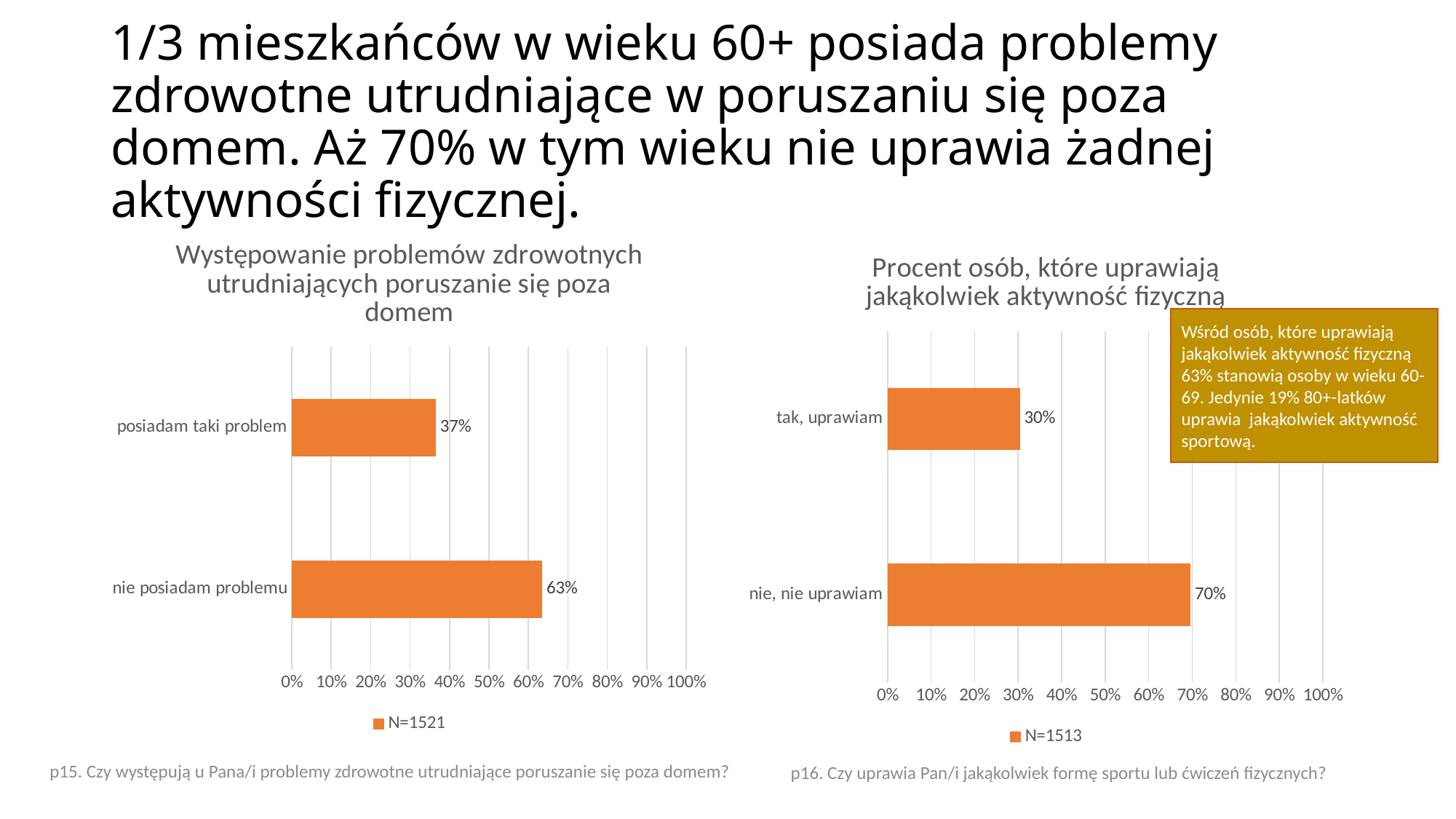
What type of chart is the right chart (Procent osób, które uprawiają jakąkolwiek aktywność fizyczną)? bar chart In the left chart, which category has the highest value? nie posiadam problemu In the left chart (Występowanie problemów zdrowotnych utrudniających poruszanie się poza domem), what is the value for 'nie posiadam problemu'? 63% In the left chart (Występowanie problemów zdrowotnych utrudniających poruszanie się poza domem), what is the value for 'posiadam taki problem'? 37% In the right chart, what is the difference between 'nie, nie uprawiam' and 'tak, uprawiam'? 40% What legend entry is shown under the left chart? N=1521 In the right chart (Procent osób, które uprawiają jakąkolwiek aktywność fizyczną), what is the value for 'tak, uprawiam'? 30% How many categories does the left chart show? 2 In the right chart, which category has the lowest value? tak, uprawiam In the right chart (Procent osób, które uprawiają jakąkolwiek aktywność fizyczną), what is the value for 'nie, nie uprawiam'? 70% In the left chart, what is the difference between 'nie posiadam problemu' and 'posiadam taki problem'? 26% In the right chart, which is larger: 'tak, uprawiam' or 'nie, nie uprawiam'? nie, nie uprawiam